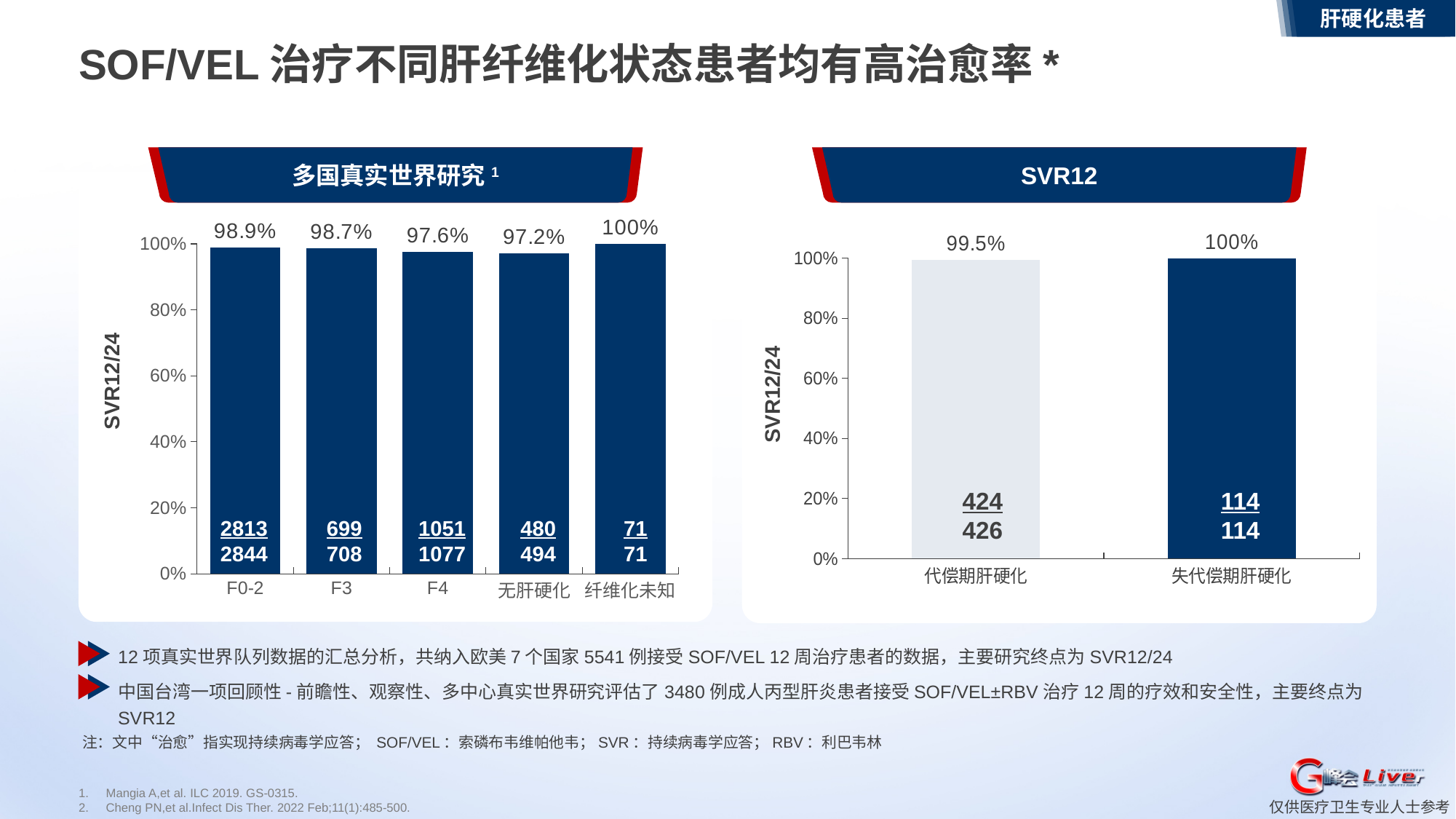
In the SVR12 chart, how many categories are shown? 2 In the 多国真实世界研究 chart, how many categories are shown on the x axis? 5 In the SVR12 chart, what is the value for 失代偿期肝硬化? 100% In the 多国真实世界研究 chart, which category has the lowest SVR12/24 value? 无肝硬化 What type of chart is the SVR12 chart? Bar chart In the 多国真实世界研究 chart, which category has the highest SVR12/24 value? 纤维化未知 In the 多国真实世界研究 chart, what is the difference between the values for F0-2 and F4? 1.3% In the 多国真实世界研究 chart, what is the value for 无肝硬化? 97.2% In the 多国真实世界研究 chart, what is the SVR12/24 value for F4? 97.6% In the SVR12 chart, what is the difference between the values for 失代偿期肝硬化 and 代偿期肝硬化? 0.5% In the SVR12 chart, what is the value for 代偿期肝硬化? 99.5% In the 多国真实世界研究 chart, what fraction is printed inside the F3 bar? 699/708